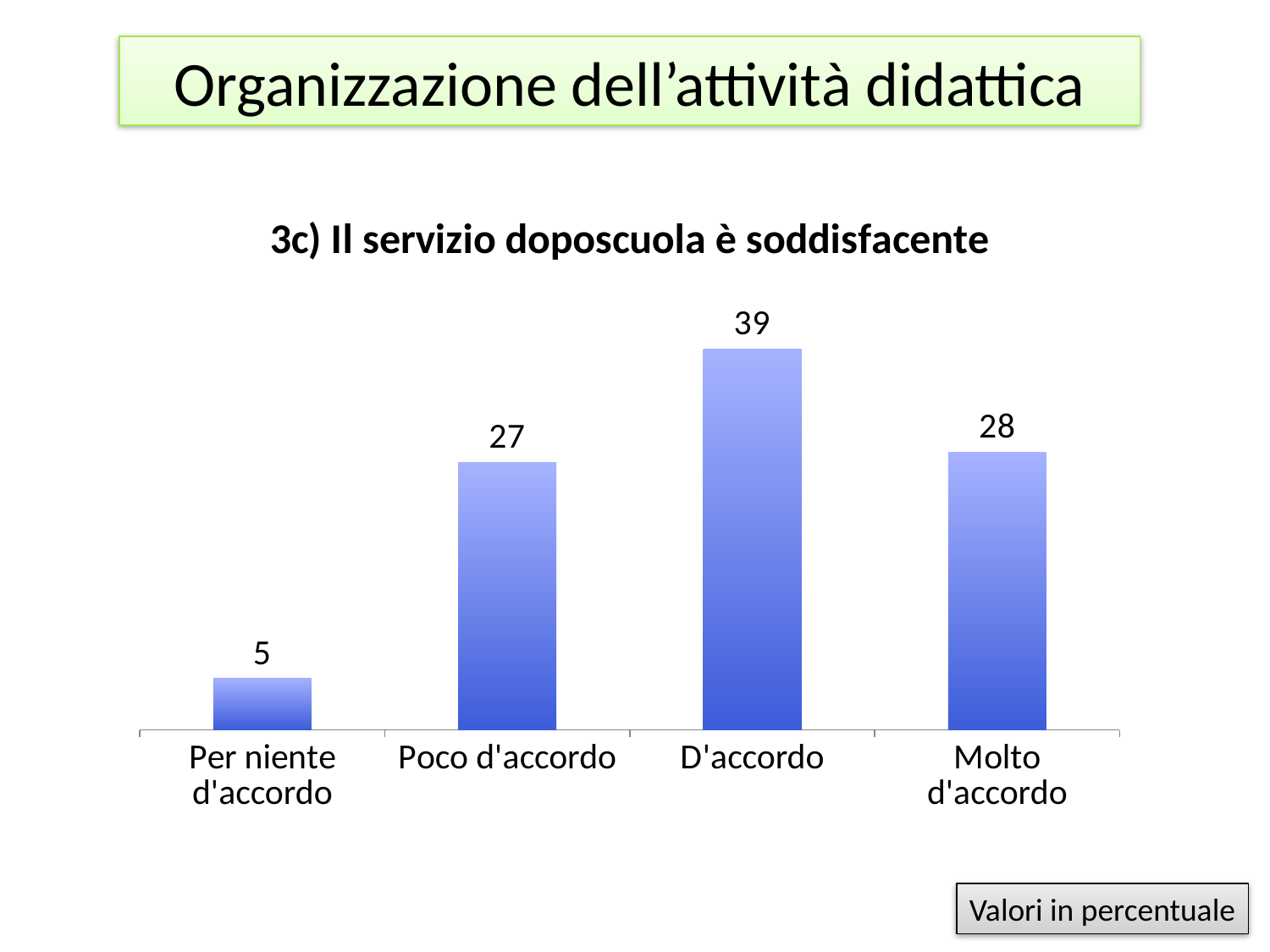
What kind of chart is shown on the slide? Bar chart What is the value for "Per niente d'accordo"? 5 What is the value for "D'accordo"? 39 Which is larger, the value for "Poco d'accordo" or the value for "Per niente d'accordo"? Poco d'accordo What is the difference between the values for "Poco d'accordo" and "Per niente d'accordo"? 22 What is the difference between the values for "D'accordo" and "Molto d'accordo"? 11 What is the value for "Molto d'accordo"? 28 Which category has the lowest value? Per niente d'accordo How many categories are shown on the x axis? 4 What is the value for "Poco d'accordo"? 27 What is the title of the chart? 3c) Il servizio doposcuola è soddisfacente Which category has the highest value? D'accordo